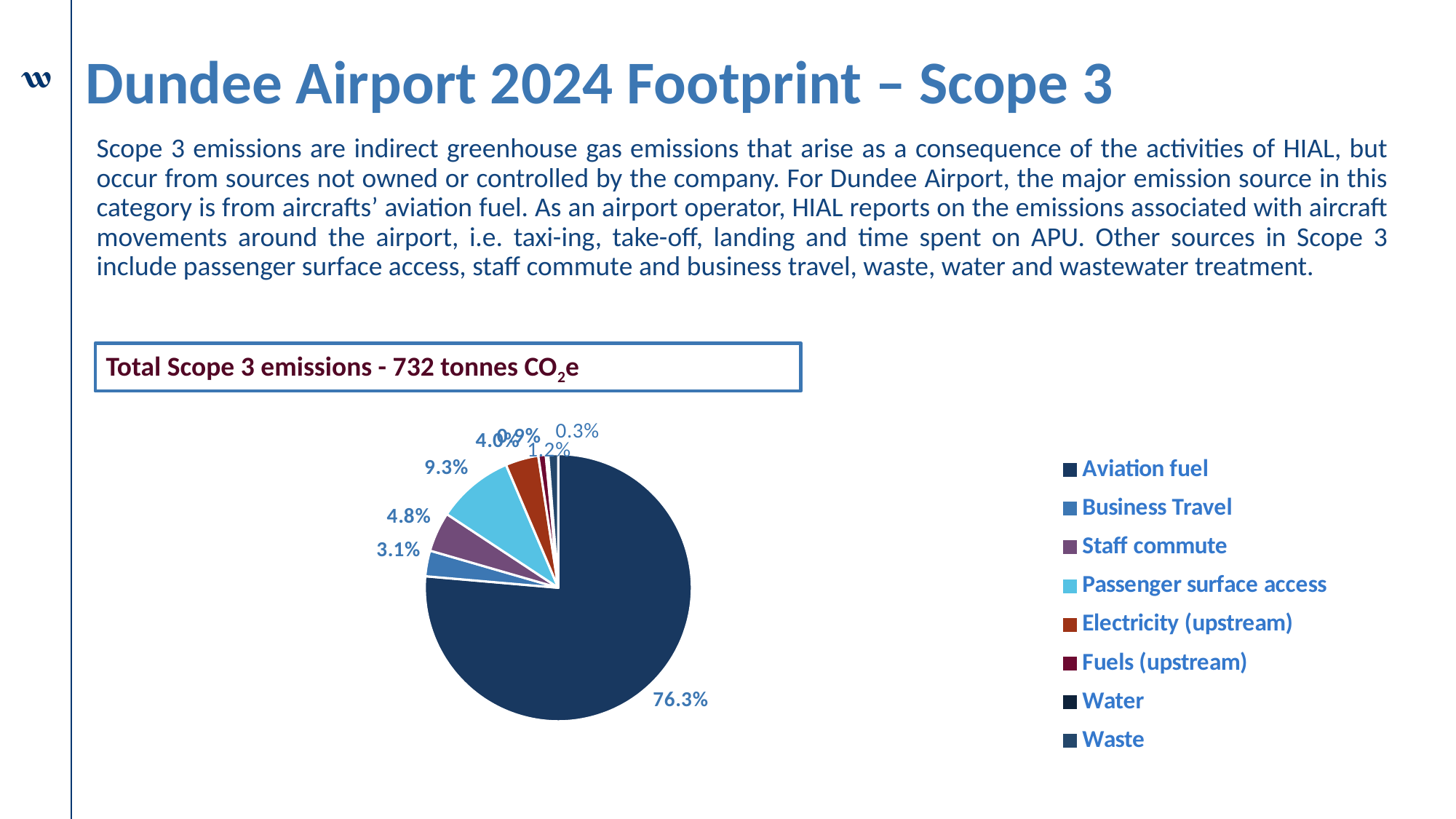
Which legend entry is listed first? Aviation fuel What total Scope 3 emissions figure is stated above the chart? 732 tonnes CO2e What kind of chart is shown on the slide? Pie chart Which category accounts for the largest share of Scope 3 emissions? Aviation fuel What share of Scope 3 emissions comes from Aviation fuel? 76.3% What is the difference in percentage points between the Aviation fuel share and the Passenger surface access share? 67.0% What share of Scope 3 emissions comes from Business Travel? 3.1% How many categories does the pie chart legend list? 8 Which is larger: the share for Staff commute or the share for Business Travel? Staff commute What share of Scope 3 emissions comes from Staff commute? 4.8% What share of Scope 3 emissions comes from Electricity (upstream)? 4.0% What share of Scope 3 emissions comes from Passenger surface access? 9.3%